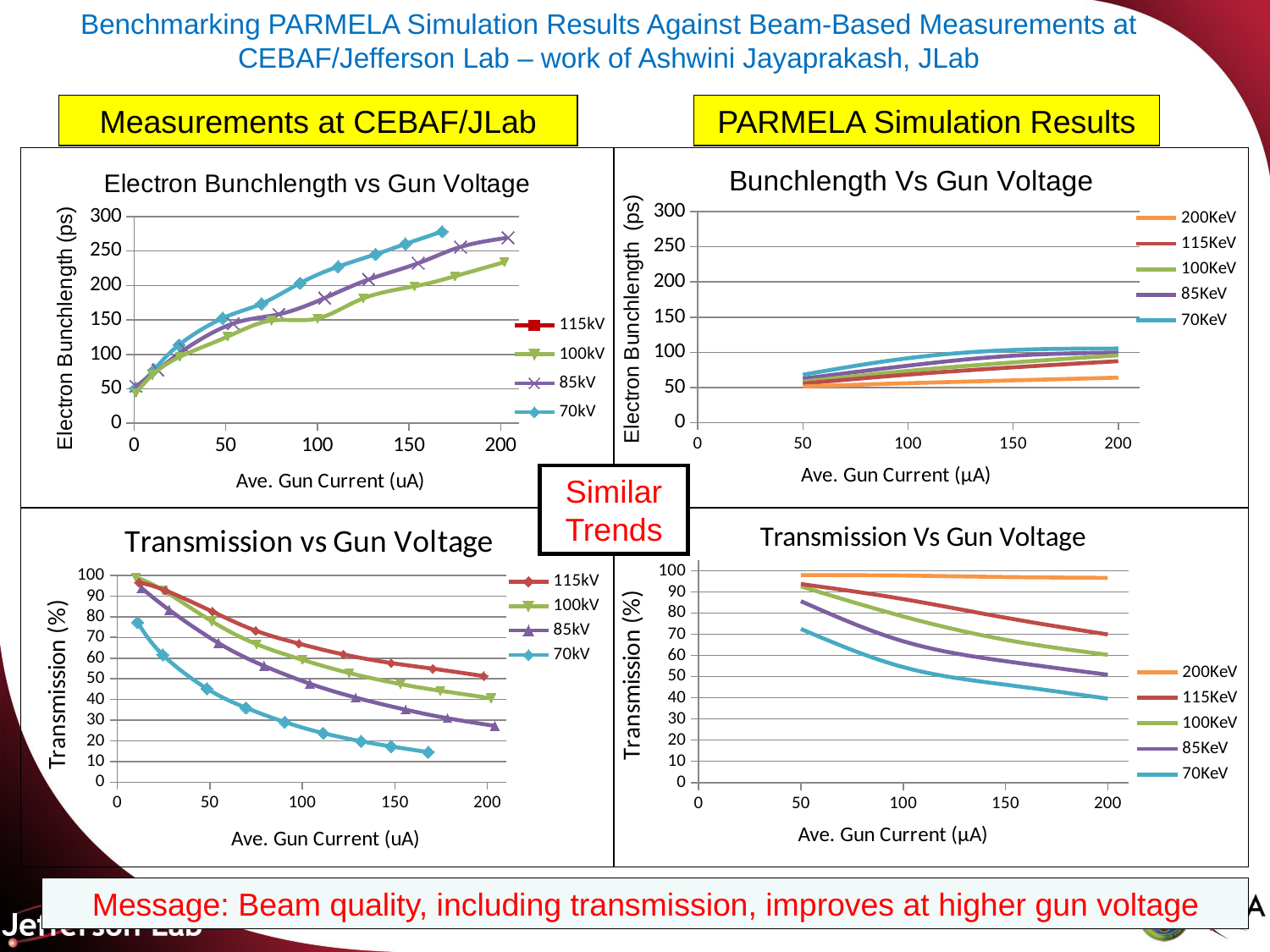
In the top-left chart 'Electron Bunchlength vs Gun Voltage', is the 100kV value at 200 uA greater or less than 200? greater What is the x-axis label of the bottom-right chart 'Transmission Vs Gun Voltage'? Ave. Gun Current (µA) What type of chart is the top-left chart titled 'Electron Bunchlength vs Gun Voltage'? line chart How many series does the legend of the top-right chart 'Bunchlength Vs Gun Voltage' list? 5 In the top-right chart 'Bunchlength Vs Gun Voltage', is the 200KeV value at 200 µA greater or less than 100? less In the top-left chart 'Electron Bunchlength vs Gun Voltage', do the bunchlength values rise or fall as the average gun current increases? rise In the bottom-left chart 'Transmission vs Gun Voltage', do the transmission values rise or fall as the average gun current increases? fall In the top-left chart 'Electron Bunchlength vs Gun Voltage', at 150 uA, which series has the larger bunchlength, 70kV or 100kV? 70kV In the bottom-right chart 'Transmission Vs Gun Voltage', is the 200KeV value at 200 µA greater or less than 90? greater In the bottom-right chart 'Transmission Vs Gun Voltage', which series has the highest transmission at 200 µA? 200KeV How many series does the legend of the bottom-left chart 'Transmission vs Gun Voltage' list? 4